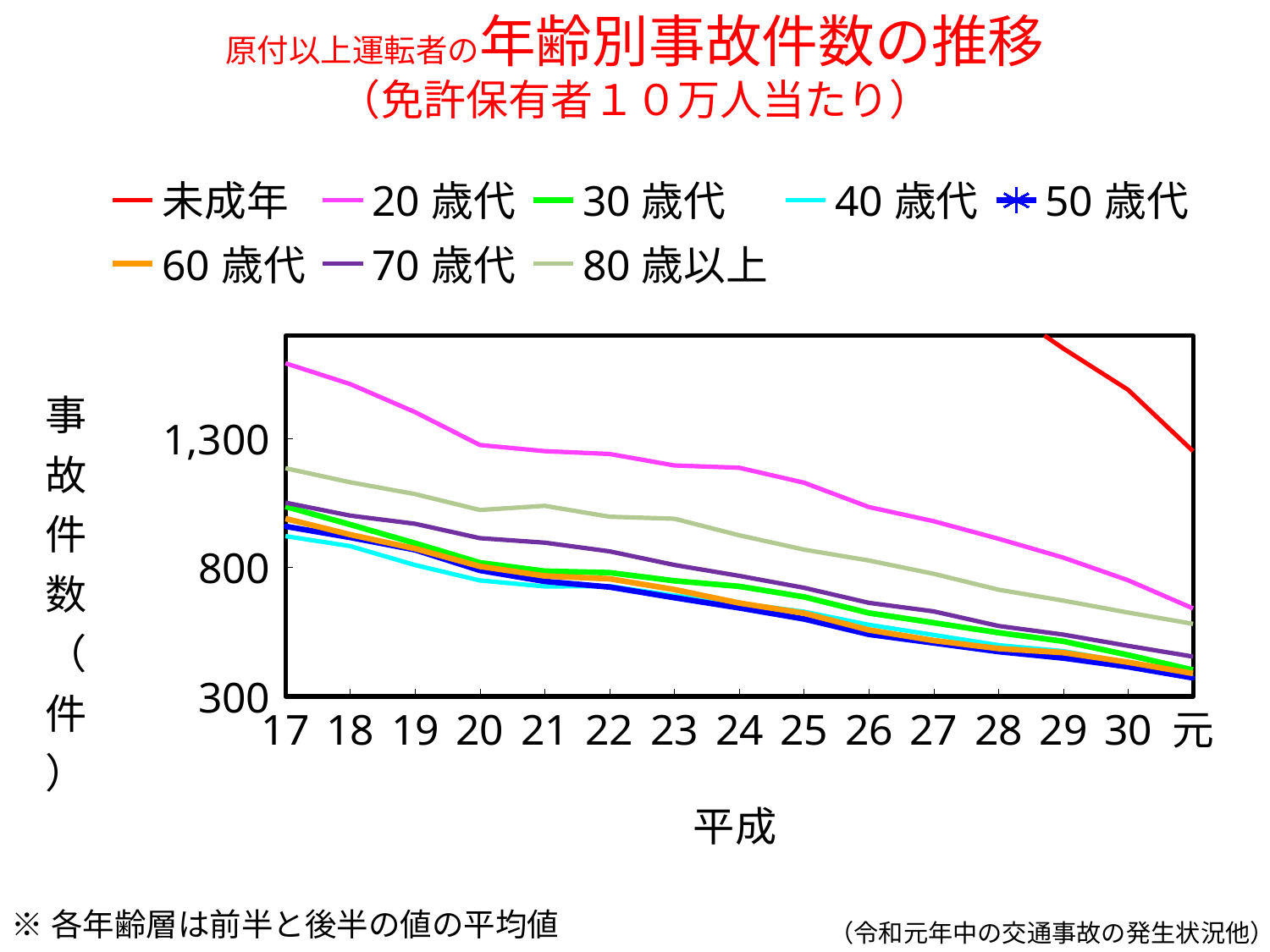
How many years are plotted along the x axis? 15 Does the value for 20歳代 rise or fall from 平成17 to 令和元年? fall Which series has the highest value in 令和元年? 未成年 Is the value for 未成年 in 平成30 greater or less than 1,300? greater Is the value for 80歳以上 in 平成17 greater or less than 1,300? less What kind of chart is shown on the slide? line chart Is the value for 40歳代 in 平成17 greater or less than 800? greater How many series does the legend list? 8 In 平成17, which is larger, the value for 20歳代 or the value for 80歳以上? 20歳代 Does the value for 80歳以上 rise or fall overall across the x axis? fall